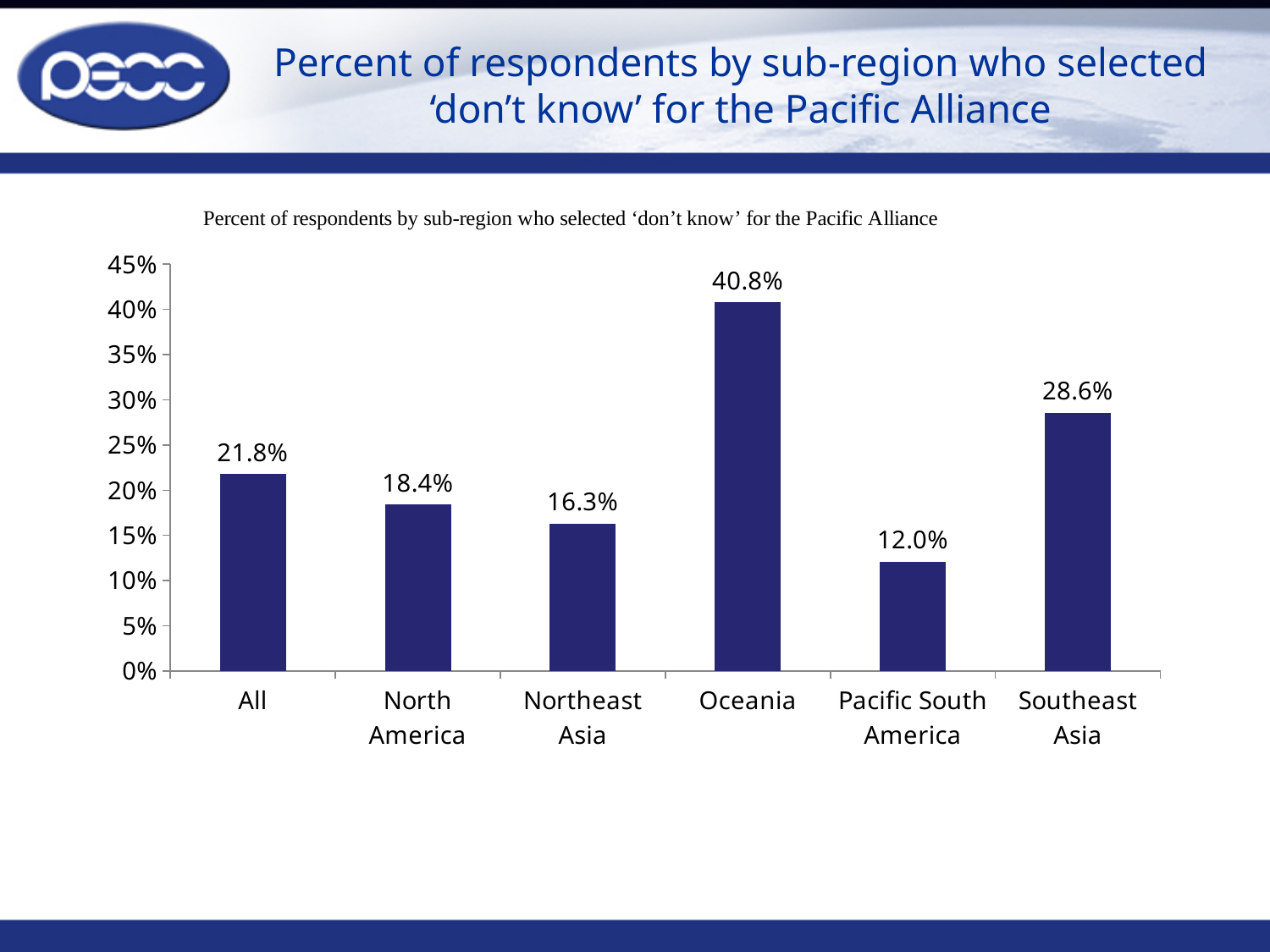
How many categories are shown on the x axis of the chart? 6 What is the difference between the values for Oceania and Southeast Asia? 12.2% What percentage of respondents in Oceania selected 'don't know' for the Pacific Alliance? 40.8% Which sub-region has the highest percentage of respondents who selected 'don't know'? Oceania What is the difference between the values for North America and Northeast Asia? 2.1% What kind of chart is shown on the slide? Bar chart What is the value shown for Pacific South America? 12.0% What percentage is shown for Northeast Asia? 16.3% Is the value for Oceania greater or less than 40%? greater What is the value shown for the 'All' category? 21.8% Which sub-region has the lowest percentage of respondents who selected 'don't know'? Pacific South America Which is larger, the value for Southeast Asia or the value for North America? Southeast Asia